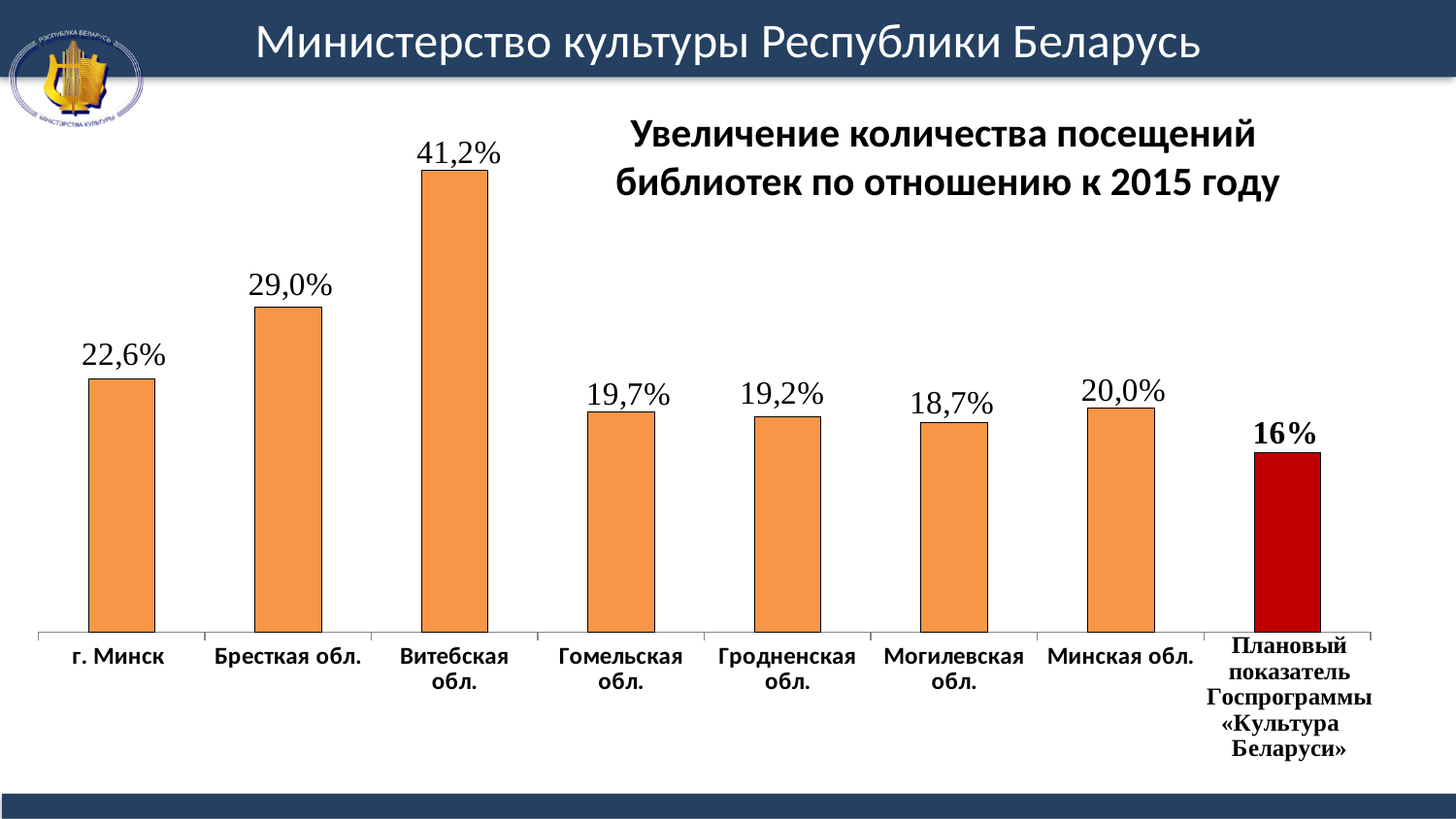
What is the value shown for Витебская обл.? 41,2% Which category has the lowest value? Плановый показатель Госпрограммы «Культура Беларуси» What is the value of the Плановый показатель Госпрограммы «Культура Беларуси» bar? 16% Which bar is coloured differently (red) from the others? Плановый показатель Госпрограммы «Культура Беларуси» Which is larger, the value for Гомельская обл. or the value for Могилевская обл.? Гомельская обл. Which category has the highest value? Витебская обл. How many bars are shown in the chart? 8 What is the value shown for г. Минск? 22,6% By how much does the value for г. Минск exceed the Плановый показатель Госпрограммы «Культура Беларуси»? 6,6% What kind of chart is shown on the slide? Bar chart What is the difference between the values for Витебская обл. and Брестская обл.? 12,2% What is the title of the chart? Увеличение количества посещений библиотек по отношению к 2015 году